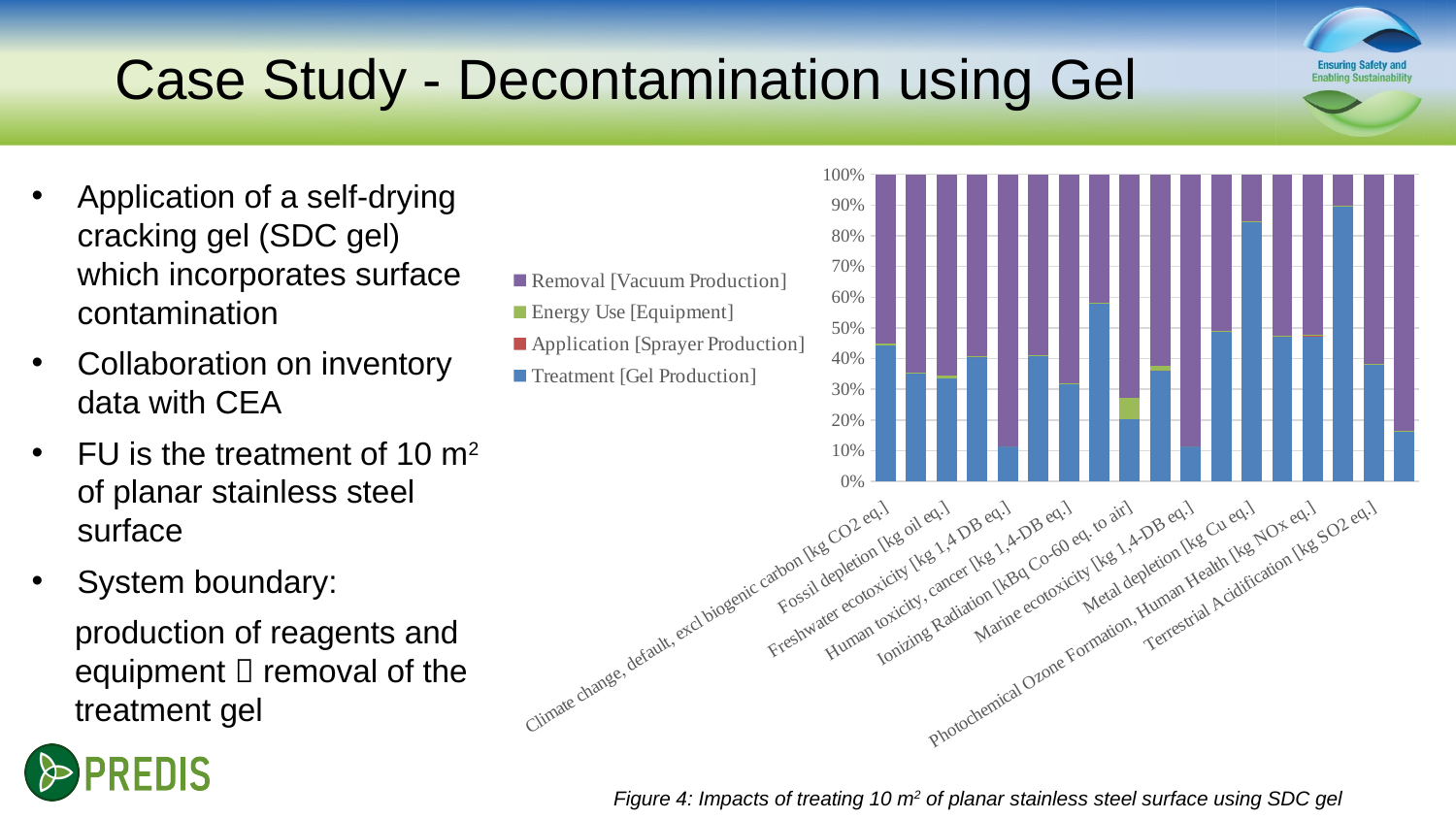
For Climate change, default, excl biogenic carbon [kg CO2 eq.], which is larger: the Removal [Vacuum Production] share or the Treatment [Gel Production] share? Removal [Vacuum Production] Which series in the chart legend is shown in blue? Treatment [Gel Production] Is the Treatment [Gel Production] share for Climate change, default, excl biogenic carbon [kg CO2 eq.] greater or less than 30%? greater How many series does the chart legend list? 4 What is the figure caption below the chart? Figure 4: Impacts of treating 10 m² of planar stainless steel surface using SDC gel What does each stacked bar in the chart total? 100% How many stacked bars are plotted in the chart? 18 What kind of chart is shown on the slide? Stacked bar chart